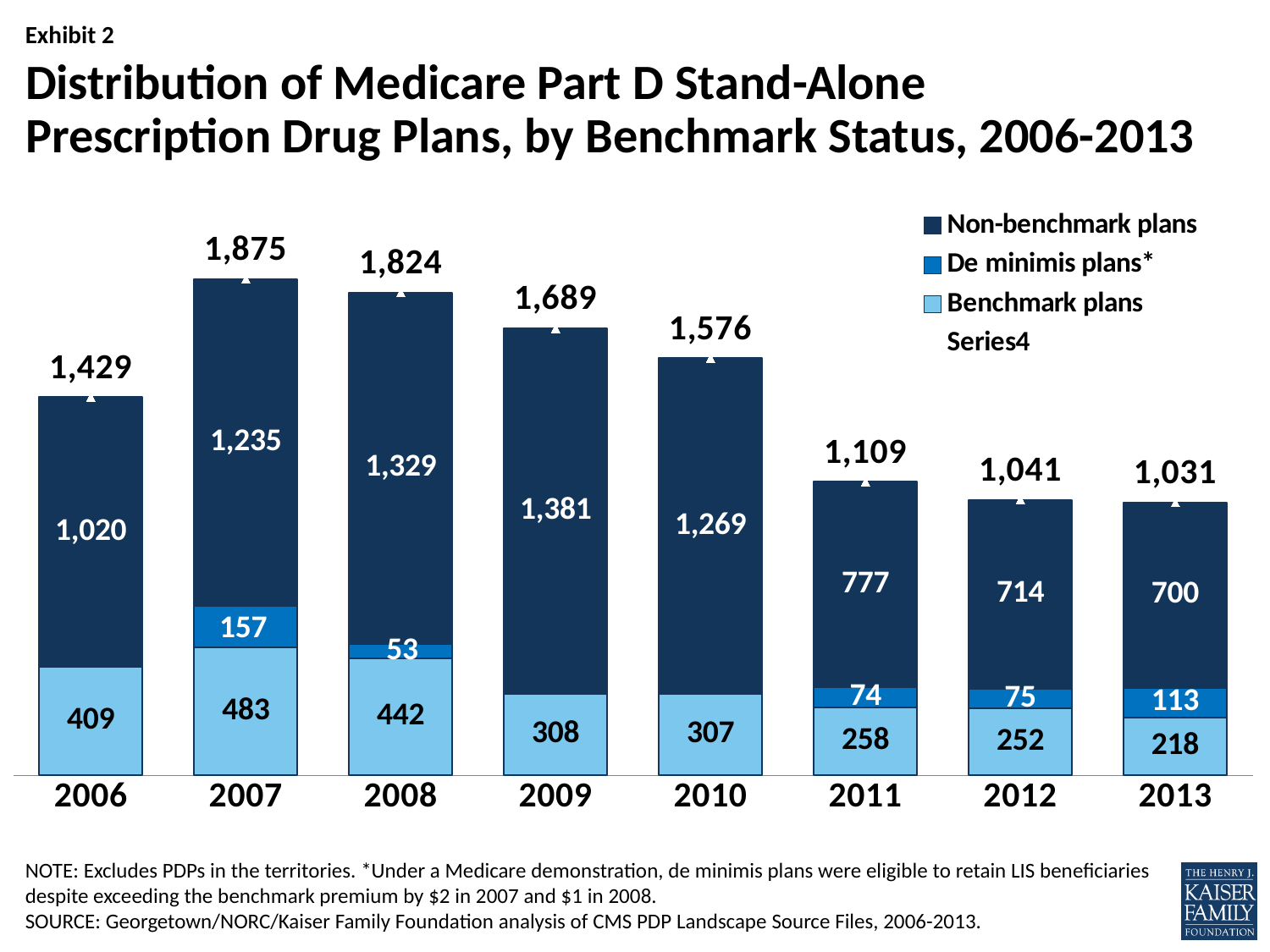
How many years are shown on the x axis? 8 What kind of chart is shown on the slide? Stacked bar chart How many benchmark plans are shown for 2006? 409 What is the difference between the number of benchmark plans in 2007 and in 2013? 265 Which year has the lowest total number of plans? 2013 How many non-benchmark plans are shown for 2009? 1,381 Do the total numbers of plans rise or fall from 2010 to 2013? Fall Which year has the highest total number of plans? 2007 How many de minimis plans are shown for 2013? 113 How many entries does the legend list? 4 What is the total number of plans shown for 2007? 1,875 Which year has more non-benchmark plans, 2008 or 2010? 2008